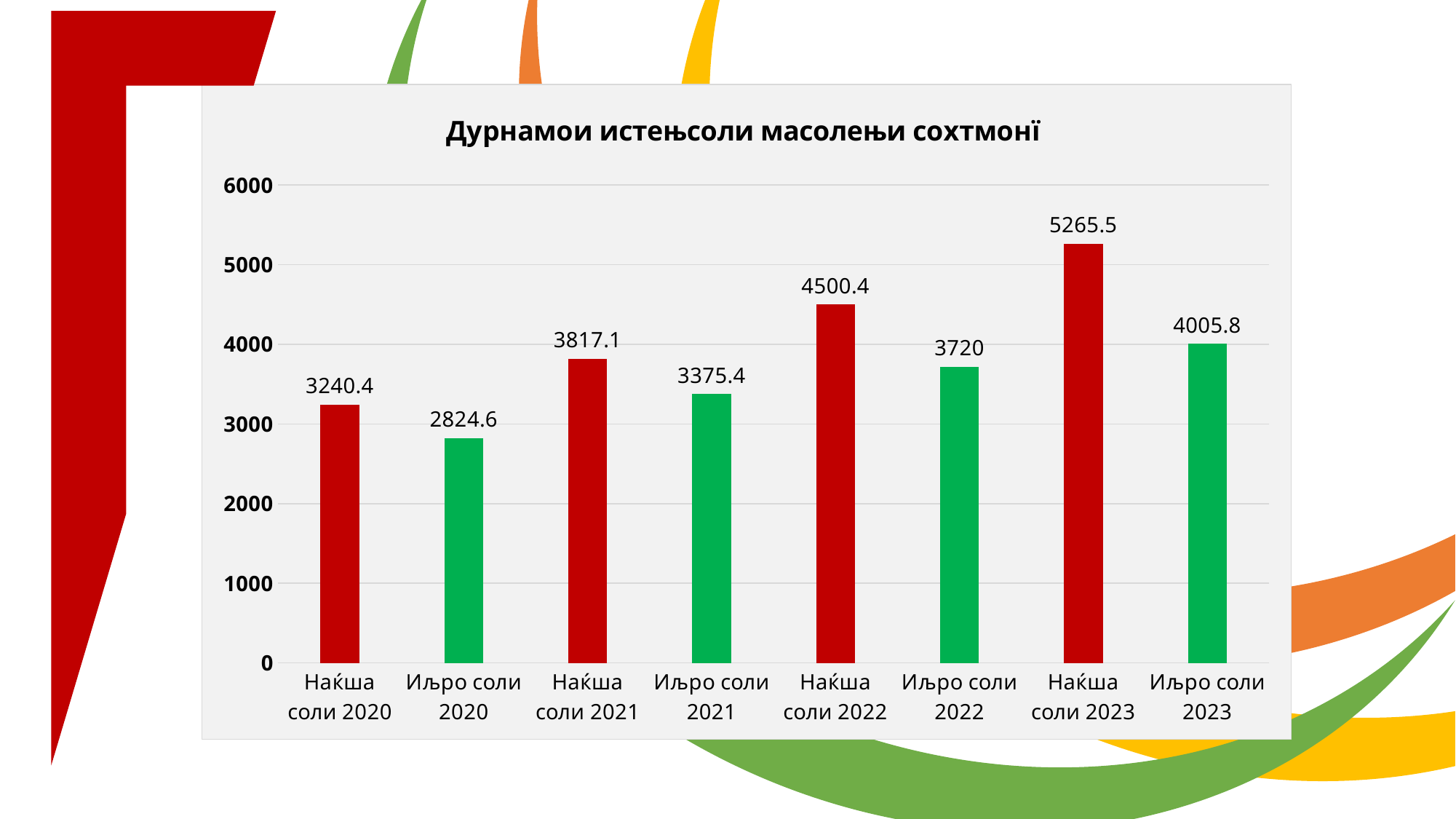
What kind of chart is shown on the slide? bar chart Which category has the lowest value? Иљро соли 2020 What is the value for Иљро соли 2020? 2824.6 Which category has the highest value? Наќша соли 2023 What is the value for Иљро соли 2022? 3720 What is the difference between Наќша соли 2022 and Иљро соли 2022? 780.4 What is the value for Наќша соли 2023? 5265.5 How many bars are shown in the chart? 8 What is the title of the chart? Дурнамои истењсоли масолењи сохтмонї What is the difference between Наќша соли 2023 and Иљро соли 2023? 1259.7 Which is larger, Наќша соли 2021 or Иљро соли 2021? Наќша соли 2021 Is the value for Наќша соли 2022 greater or less than 4000? greater